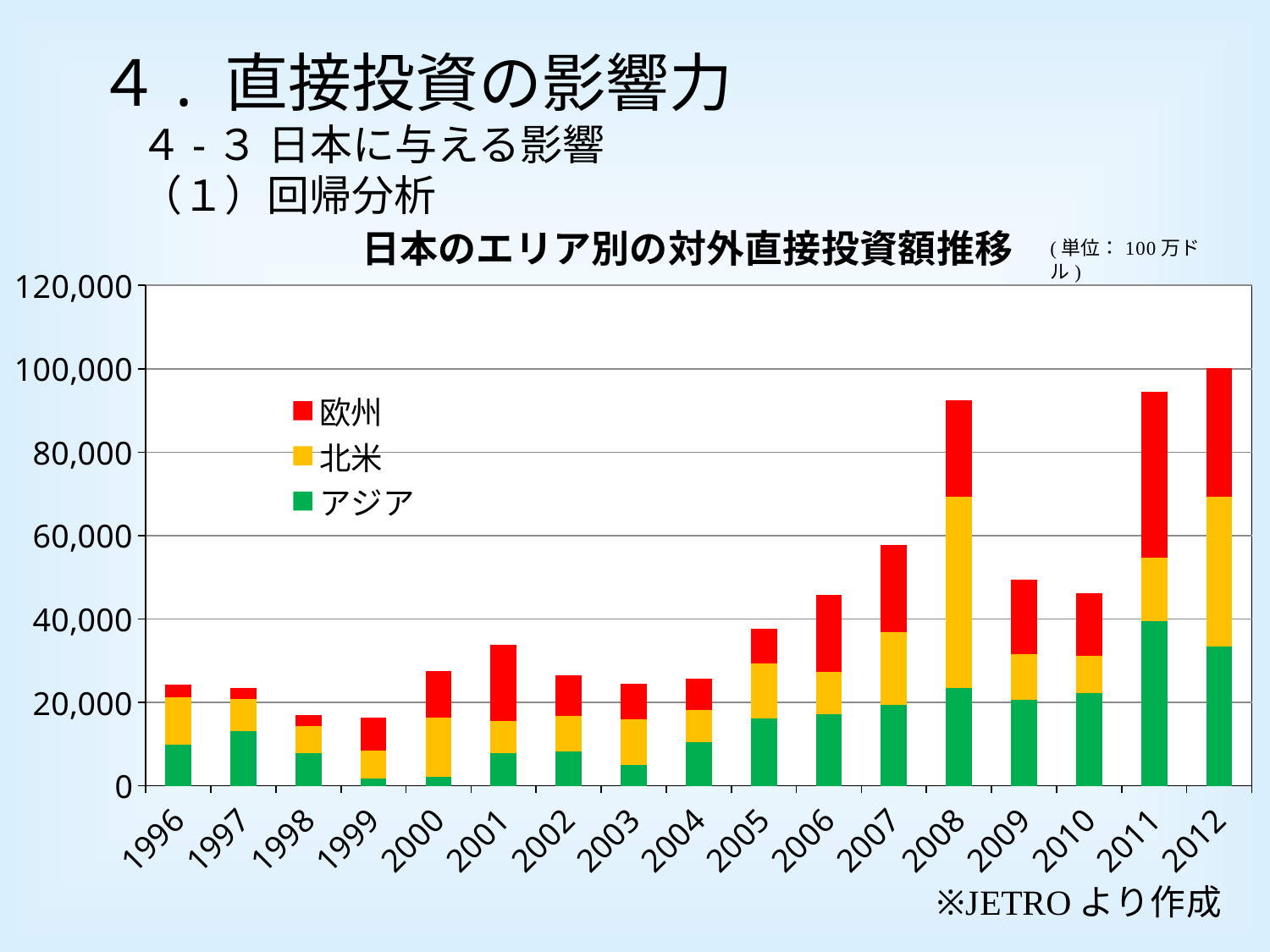
Which colour represents 欧州 in the chart? red Which year has the highest total bar in the chart? 2012 How many years are shown on the x axis of the chart? 17 What is the title of the chart? 日本のエリア別の対外直接投資額推移 Is the アジア value for 1999 greater or less than 20,000? less Is the total value for 2008 greater or less than 80,000? greater Which year has the larger total bar, 2010 or 2011? 2011 What kind of chart is shown on the slide? stacked bar chart Is the アジア value for 2011 greater or less than 20,000? greater How many series does the legend list? 3 Overall, do the total bars rise or fall from 1996 to 2012? rise